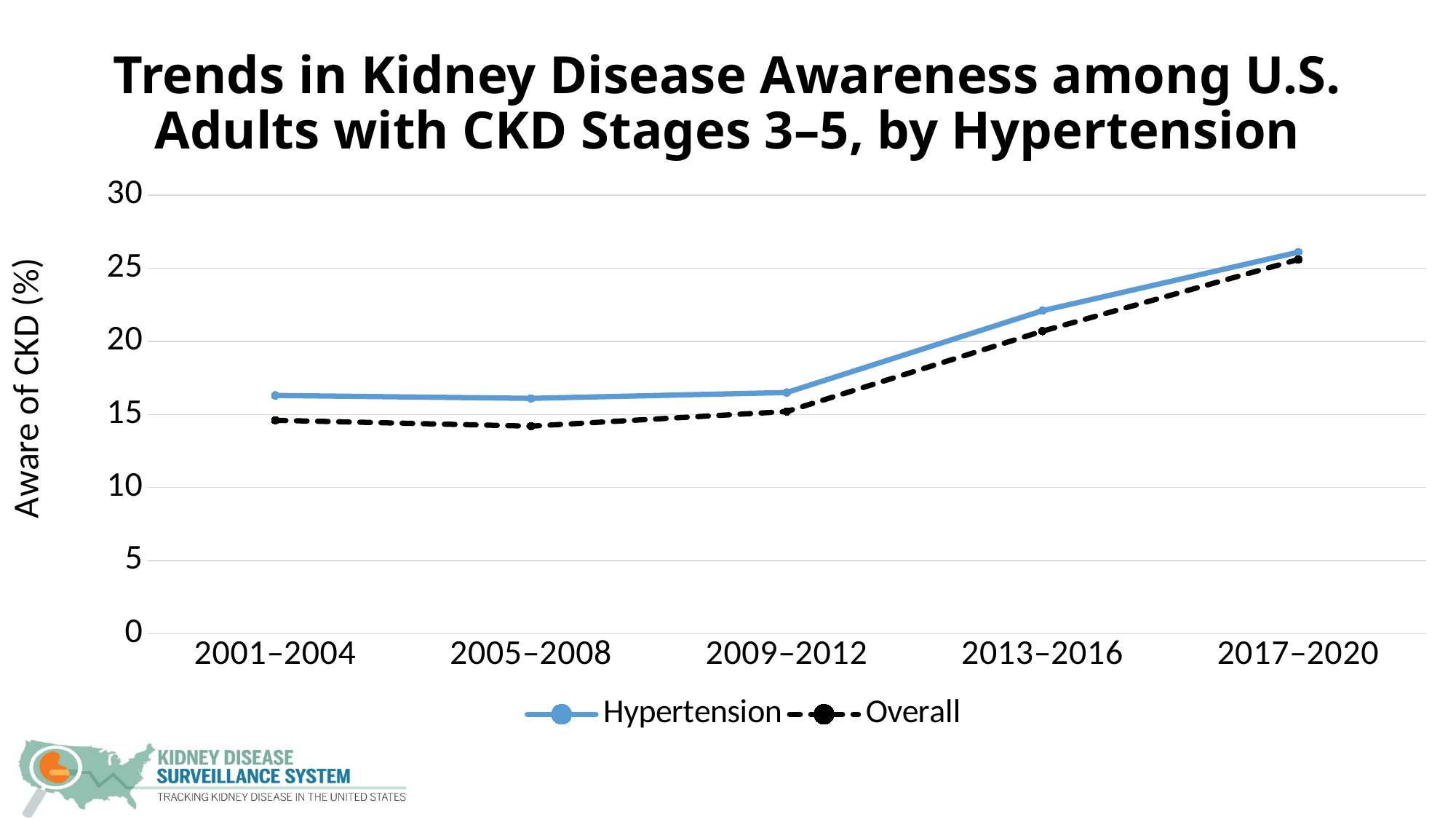
What kind of chart is shown on the slide? Line chart In which period is the Overall series at its highest? 2017–2020 What is the label of the y axis? Aware of CKD (%) How many series does the legend list? 2 Is the value for Overall in 2005–2008 greater or less than 15? less In which period is the Hypertension series at its highest? 2017–2020 Is the value for Hypertension in 2013–2016 greater or less than 20? greater In 2013–2016, which series has the higher value, Hypertension or Overall? Hypertension Is the value for Hypertension in 2001–2004 greater or less than 15? greater Which series are listed in the legend? Hypertension and Overall Does the Overall series rise or fall from 2009–2012 to 2017–2020? Rise How many time periods are plotted along the x axis? 5